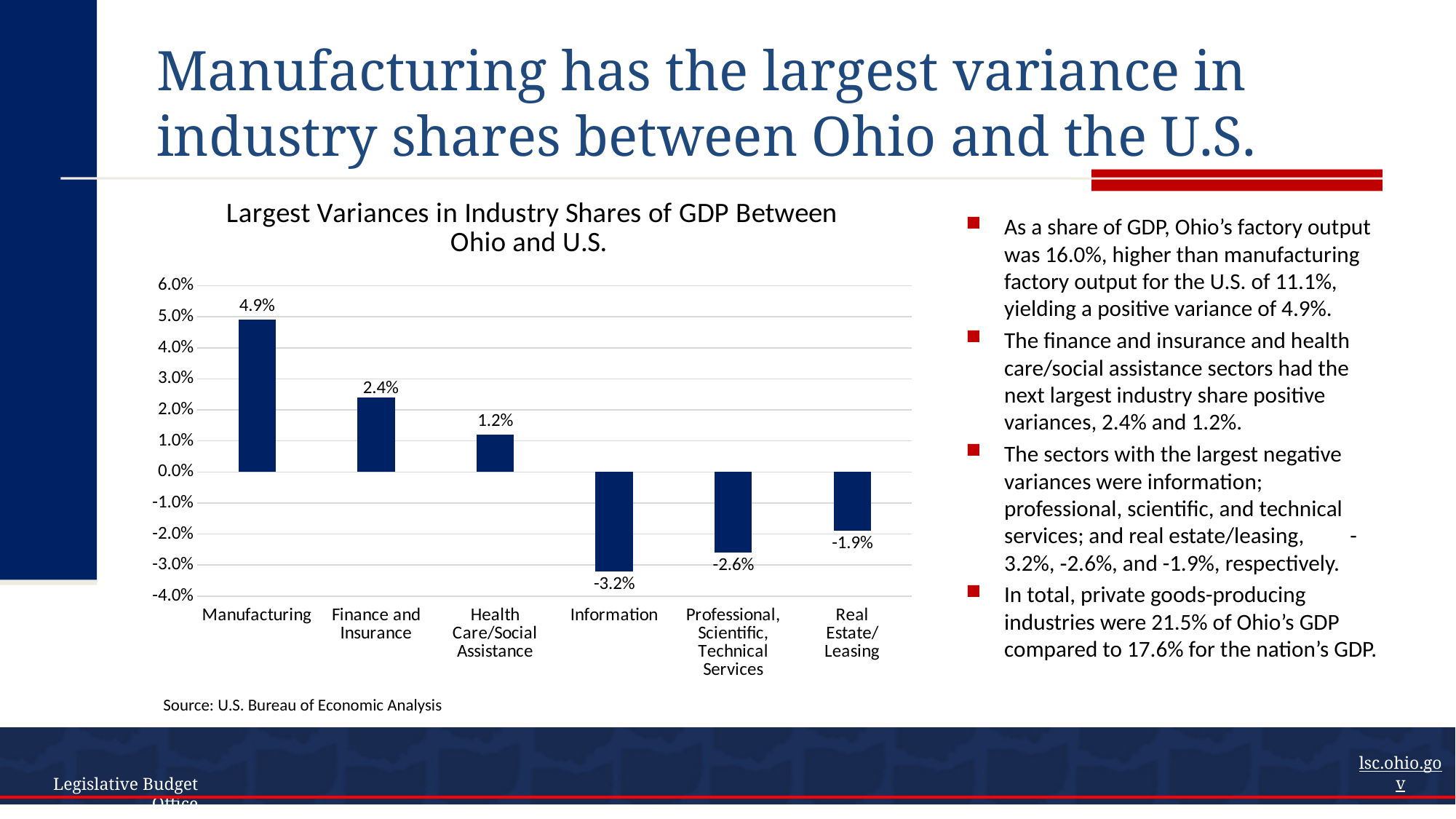
What is the difference between the values for Manufacturing and Finance and Insurance? 2.5% Which is larger, the value for Health Care/Social Assistance or the value for Finance and Insurance? Finance and Insurance What is the value for Information? -3.2% Which category has the highest value? Manufacturing What is the title of the chart? Largest Variances in Industry Shares of GDP Between Ohio and U.S. What kind of chart is shown on the slide? Bar chart Do the values rise or fall from Manufacturing to Health Care/Social Assistance? Fall Which category has the lowest value? Information What is the value for Finance and Insurance? 2.4% What is the value for Real Estate/Leasing? -1.9% How many categories are shown in the chart? 6 What is the value for Manufacturing? 4.9%